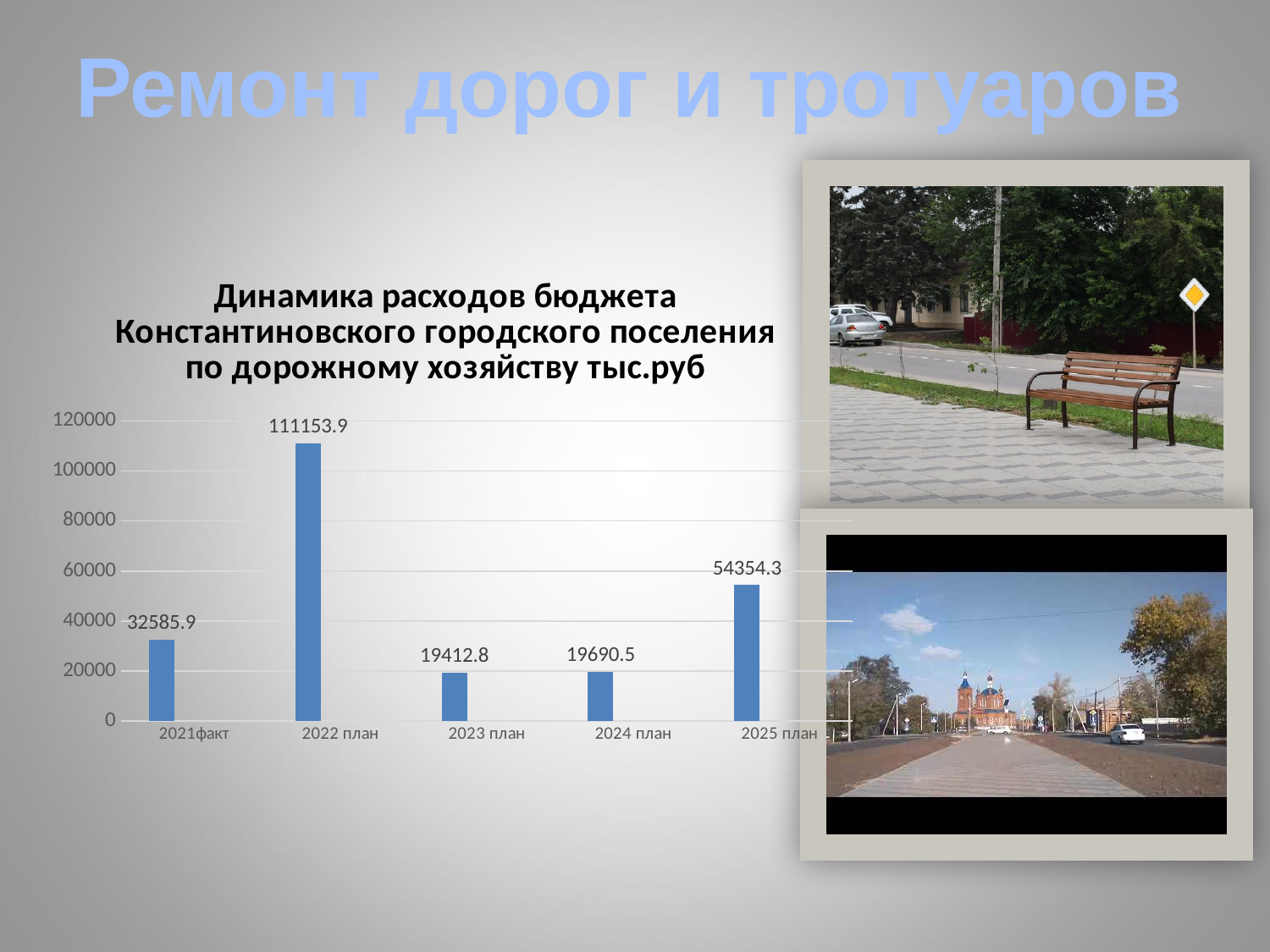
What kind of chart is shown on the slide? bar chart Which is larger, the value for 2025 план or the value for 2021факт? 2025 план What is the difference between the values for 2022 план and 2021факт? 78568 How many categories are shown on the x axis? 5 What is the value for 2025 план? 54354.3 Which category has the highest value? 2022 план What is the difference between the values for 2025 план and 2024 план? 34663.8 What is the value for 2021факт? 32585.9 What is the value for 2022 план? 111153.9 Is the value for 2022 план greater or less than 100000? greater Which category has the lowest value? 2023 план What is the value for 2024 план? 19690.5